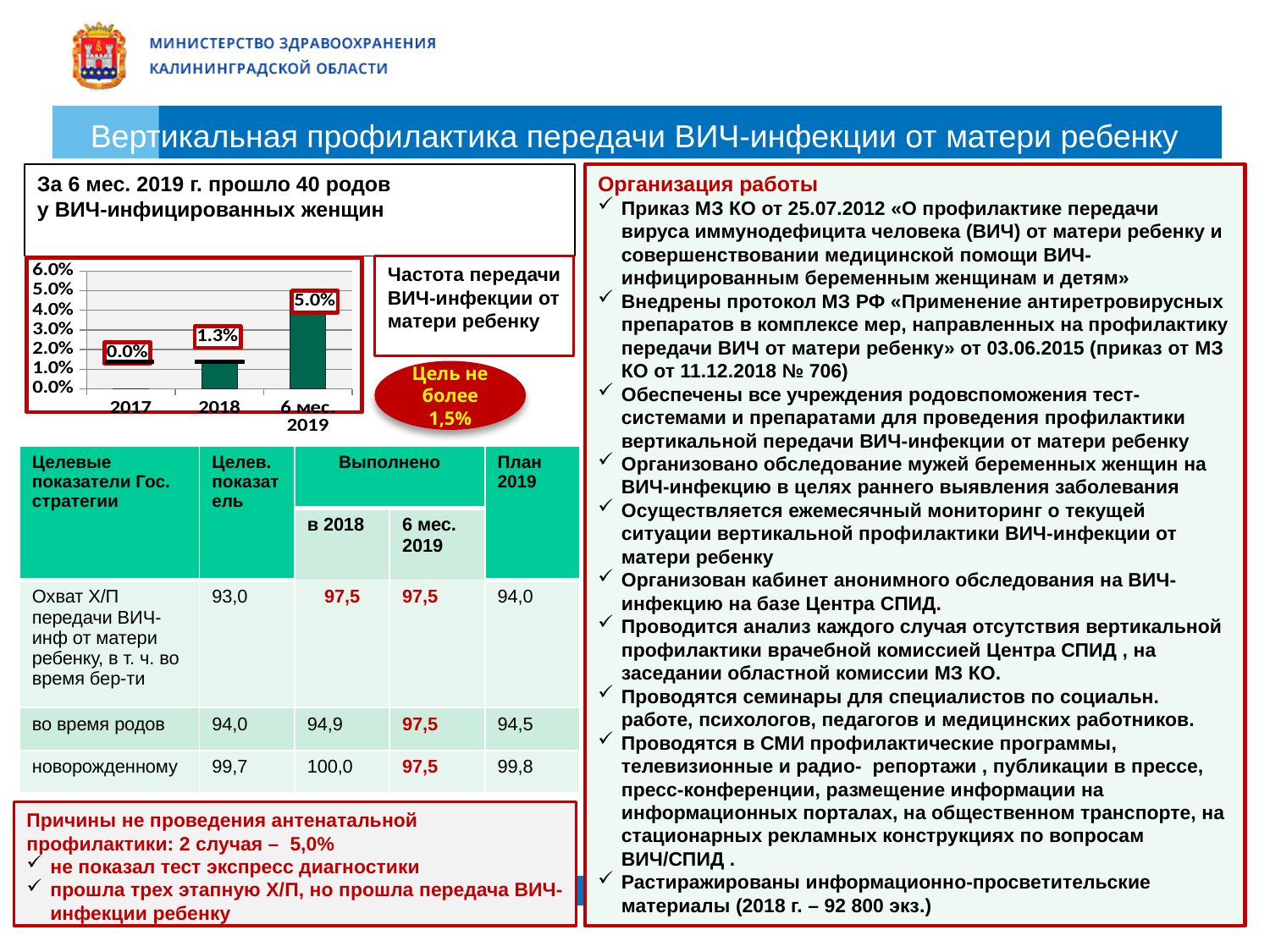
How many categories are shown on the x axis of the chart? 3 Which category has the highest value in the chart? 6 мес. 2019 What is the value shown for 6 мес. 2019 in the chart? 5.0% What is the highest tick value shown on the y axis of the chart? 6.0% What is the value shown for 2018 in the chart? 1.3% What is the difference between the values for 6 мес. 2019 and 2018 in the chart? 3.7% Which category has the lowest value in the chart? 2017 Do the values in the chart rise or fall from 2017 to 6 мес. 2019? rise What is the value shown for 2017 in the chart? 0.0% Is the value for 6 мес. 2019 greater or less than 4.0%? greater Which is larger in the chart, the value for 2018 or the value for 6 мес. 2019? 6 мес. 2019 What kind of chart is shown on the slide? bar chart